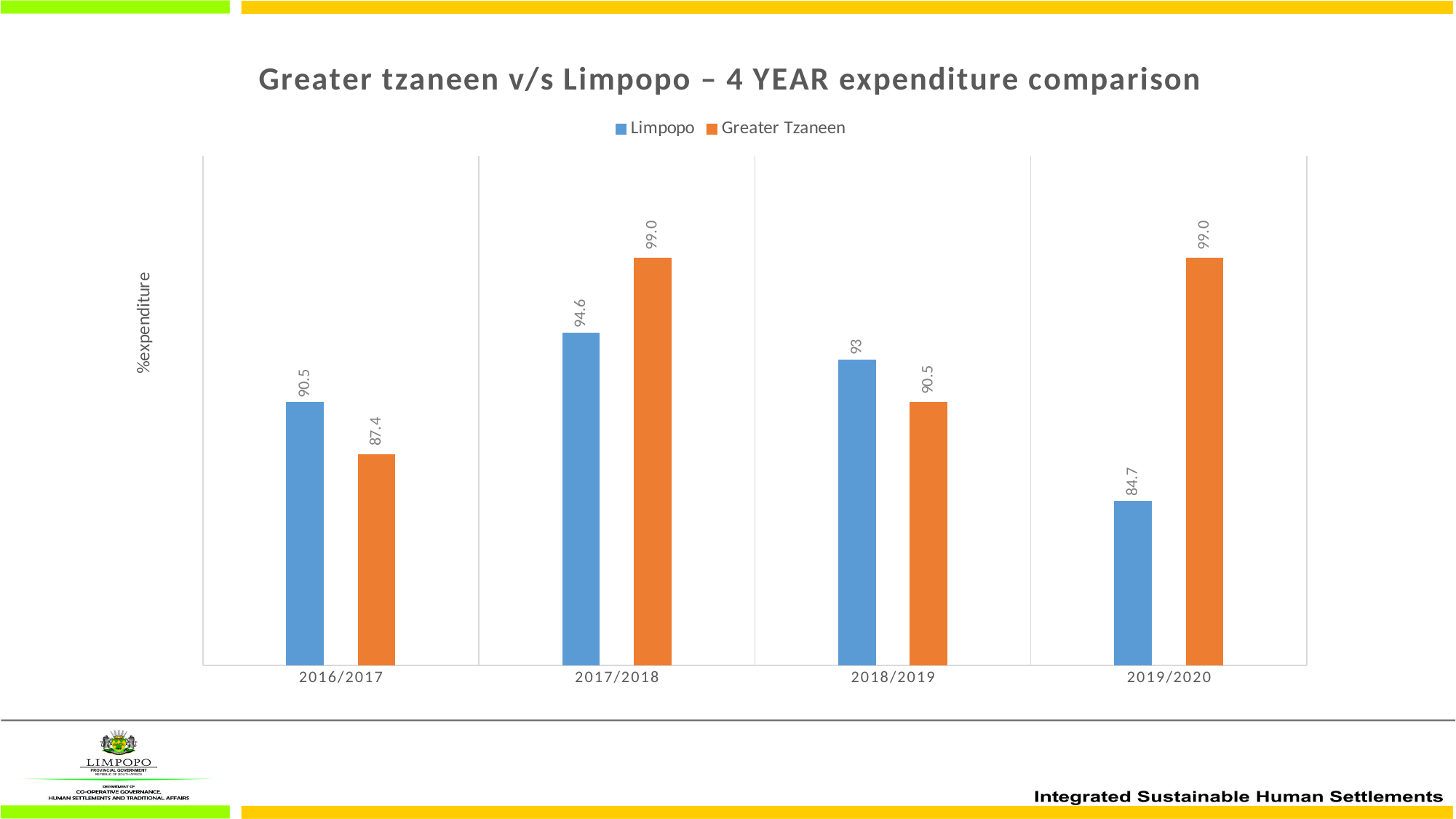
What is the Limpopo value for 2019/2020? 84.7 In which year is the Limpopo value highest? 2017/2018 How many years are shown on the x axis? 4 What is the Greater Tzaneen value for 2018/2019? 90.5 What kind of chart is shown? Bar chart How many series does the legend list? 2 What is the difference between the Greater Tzaneen and Limpopo values in 2019/2020? 14.3 In which year is the Limpopo value lowest? 2019/2020 Which is larger in 2018/2019, Limpopo or Greater Tzaneen? Limpopo What is the label on the vertical axis? %expenditure What is the Limpopo value for 2016/2017? 90.5 What is the Greater Tzaneen value for 2017/2018? 99.0